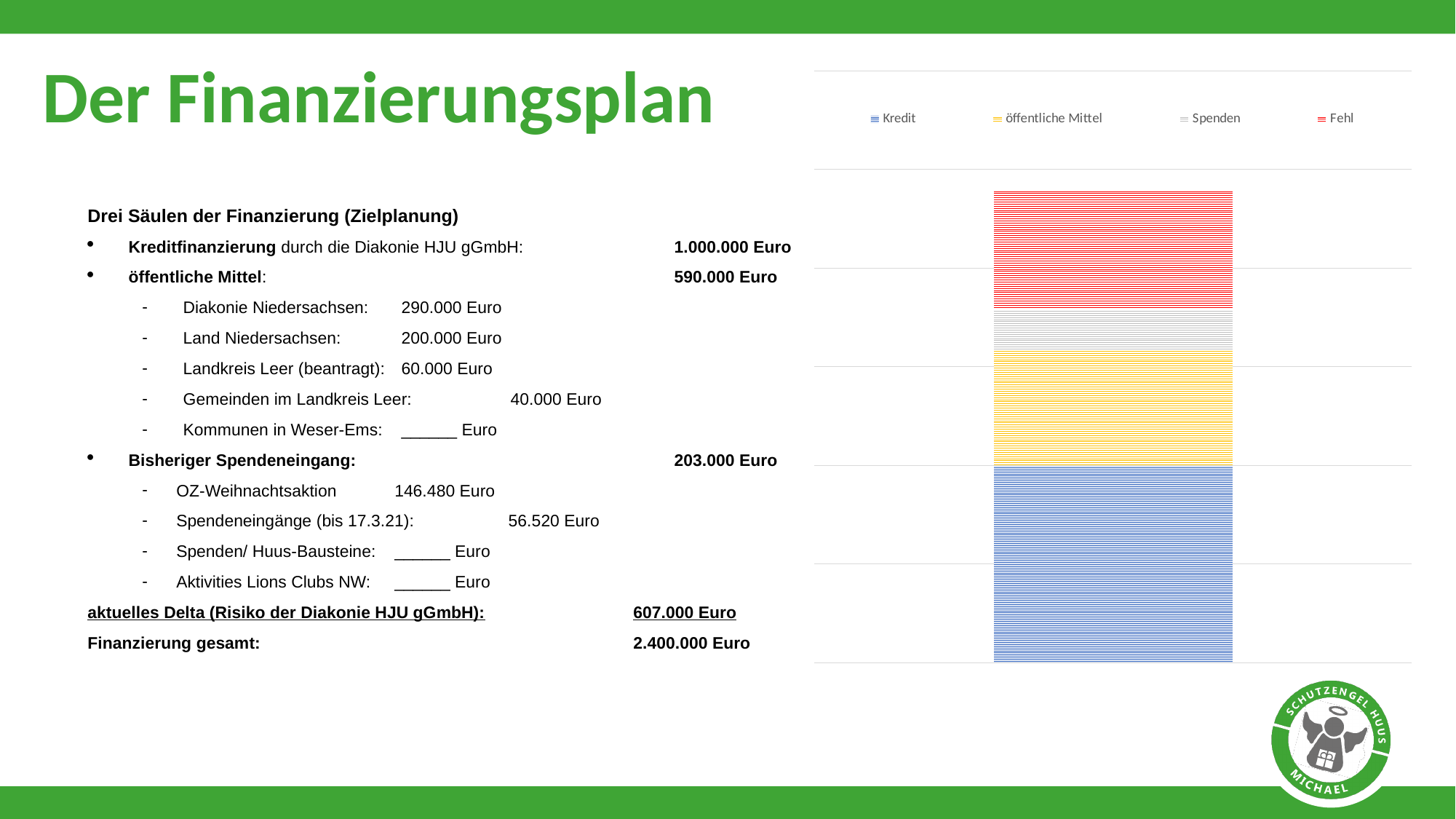
How many series does the chart legend list? 4 What kind of chart is shown on the right side of the slide? Stacked bar chart Which series occupies the largest segment of the stacked bar? Kredit Which segment is larger in the stacked bar, Kredit or Fehl? Kredit Which series is shown at the bottom of the stacked bar? Kredit Which segment is larger in the stacked bar, Fehl or Spenden? Fehl How many bars are plotted in the chart? 1 Which segment is larger in the stacked bar, öffentliche Mittel or Spenden? öffentliche Mittel Which series occupies the smallest segment of the stacked bar? Spenden Which series is listed last in the chart legend? Fehl Which series is listed first in the chart legend? Kredit